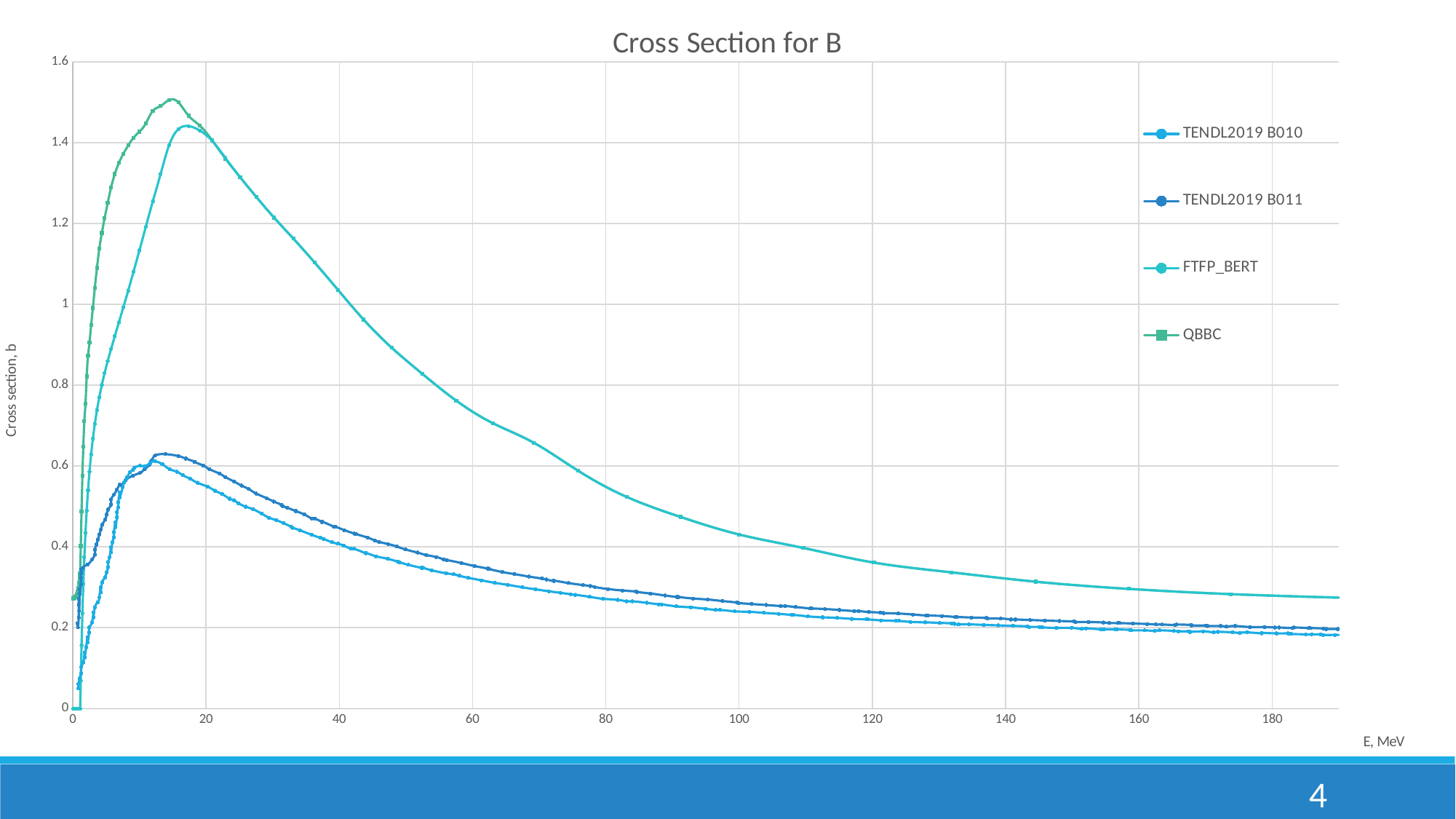
How many series does the legend list? 4 What kind of chart is shown on the slide? line chart What is the label of the y axis? Cross section, b Which series reaches the highest peak value? QBBC Is the peak value of the TENDL2019 B011 series greater or less than 0.8? less Is the value of the FTFP_BERT series at 100 MeV greater or less than 0.6? less What is the title of the chart? Cross Section for B Is the peak value of the QBBC series greater or less than 1.4? greater Between 40 MeV and 180 MeV, do the values of the FTFP_BERT series rise or fall as energy increases? fall At 100 MeV, which series has the larger value, FTFP_BERT or TENDL2019 B011? FTFP_BERT